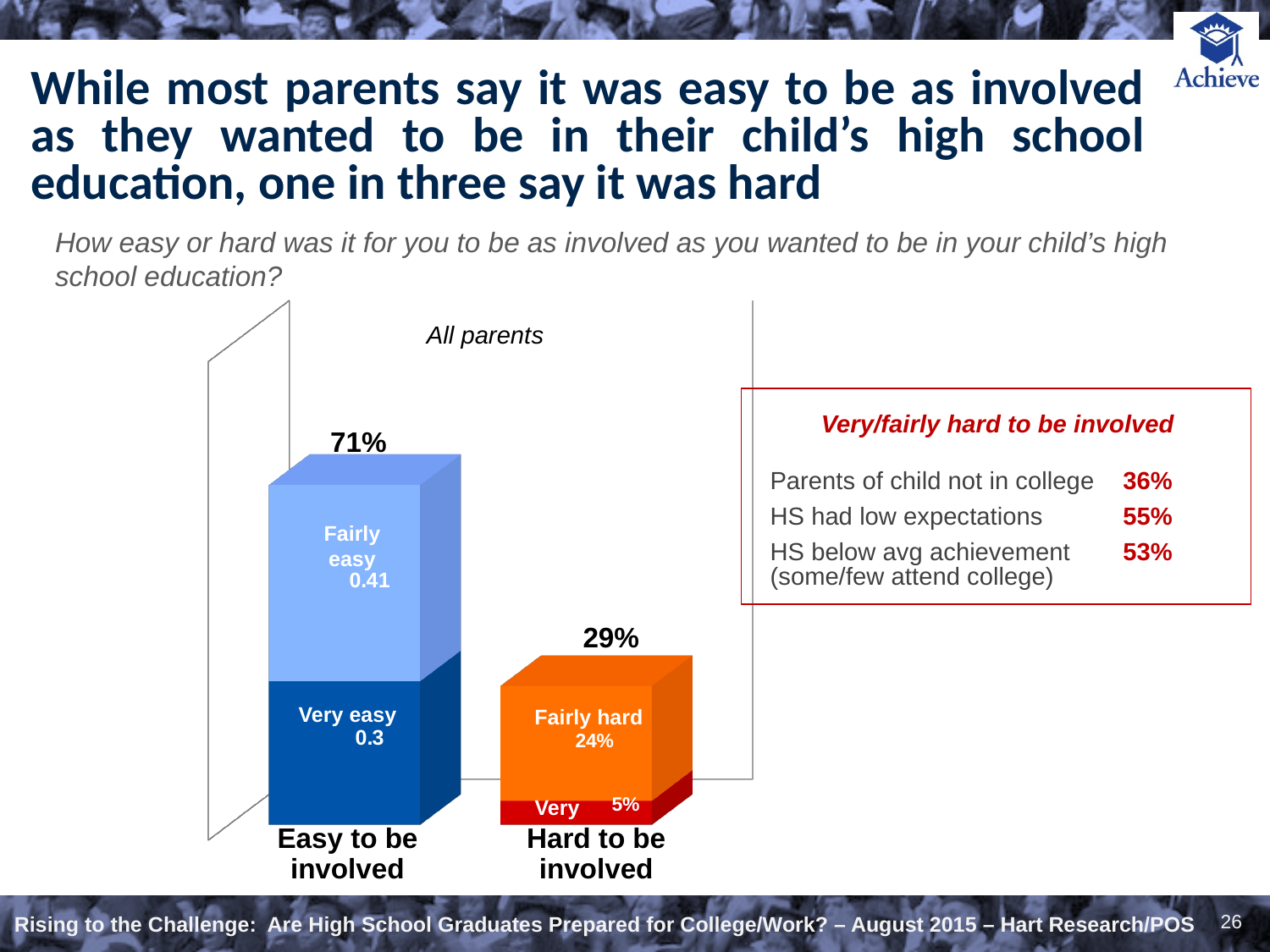
What group label appears above the chart in italics? All parents What value is labelled for the 'Very easy' segment? 0.3 How many categories are plotted on the x axis of the chart? 2 Which bar is taller, 'Easy to be involved' or 'Hard to be involved'? Easy to be involved What is the difference between the 'Fairly hard' segment (24%) and the 'Very' hard segment (5%)? 19 percentage points What is the difference between the 'Easy to be involved' total (71%) and the 'Hard to be involved' total (29%)? 42 percentage points What is the total value shown for the 'Hard to be involved' bar? 29% What value is labelled for the 'Very' (very hard) segment of the 'Hard to be involved' bar? 5% What kind of chart is shown on the slide? Stacked bar chart What value is labelled for the 'Fairly easy' segment? 0.41 What is the total value shown for the 'Easy to be involved' bar? 71% What value is labelled for the 'Fairly hard' segment? 24%